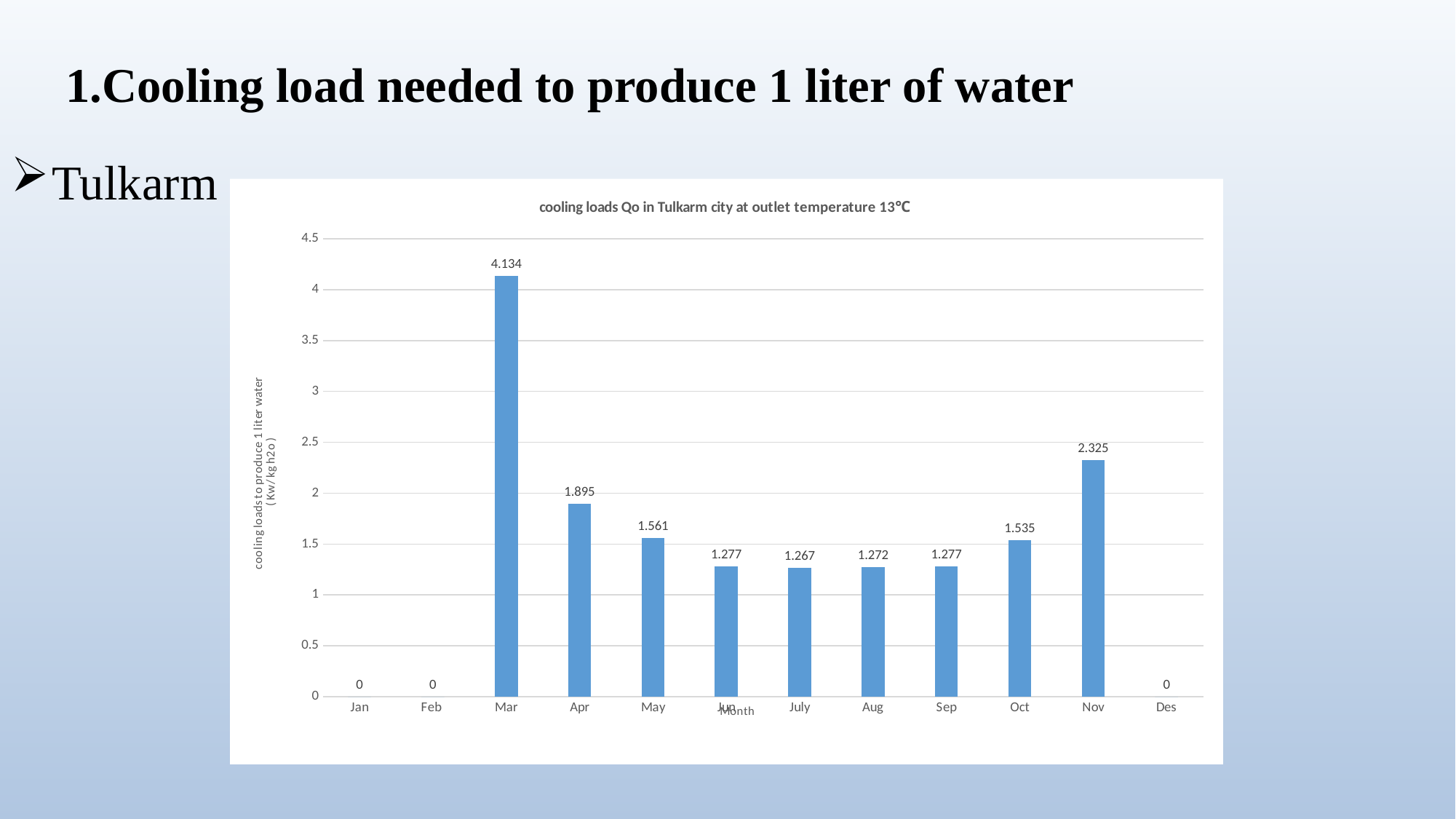
What is the title of the chart? cooling loads Qo in Tulkarm city at outlet temperature 13℃ What kind of chart is shown on the slide? Bar chart Which has a larger cooling load value, Apr or Nov? Nov What is the difference between the cooling load values for Apr and May? 0.334 What is the cooling load value for Mar? 4.134 What is the cooling load value for July? 1.267 Is the value for Mar greater or less than 4? greater What is the cooling load value for Nov? 2.325 What is the cooling load value for Oct? 1.535 Which month has the highest cooling load? Mar How many months are shown on the x axis? 12 What is the difference between the cooling load values for Mar and Nov? 1.809